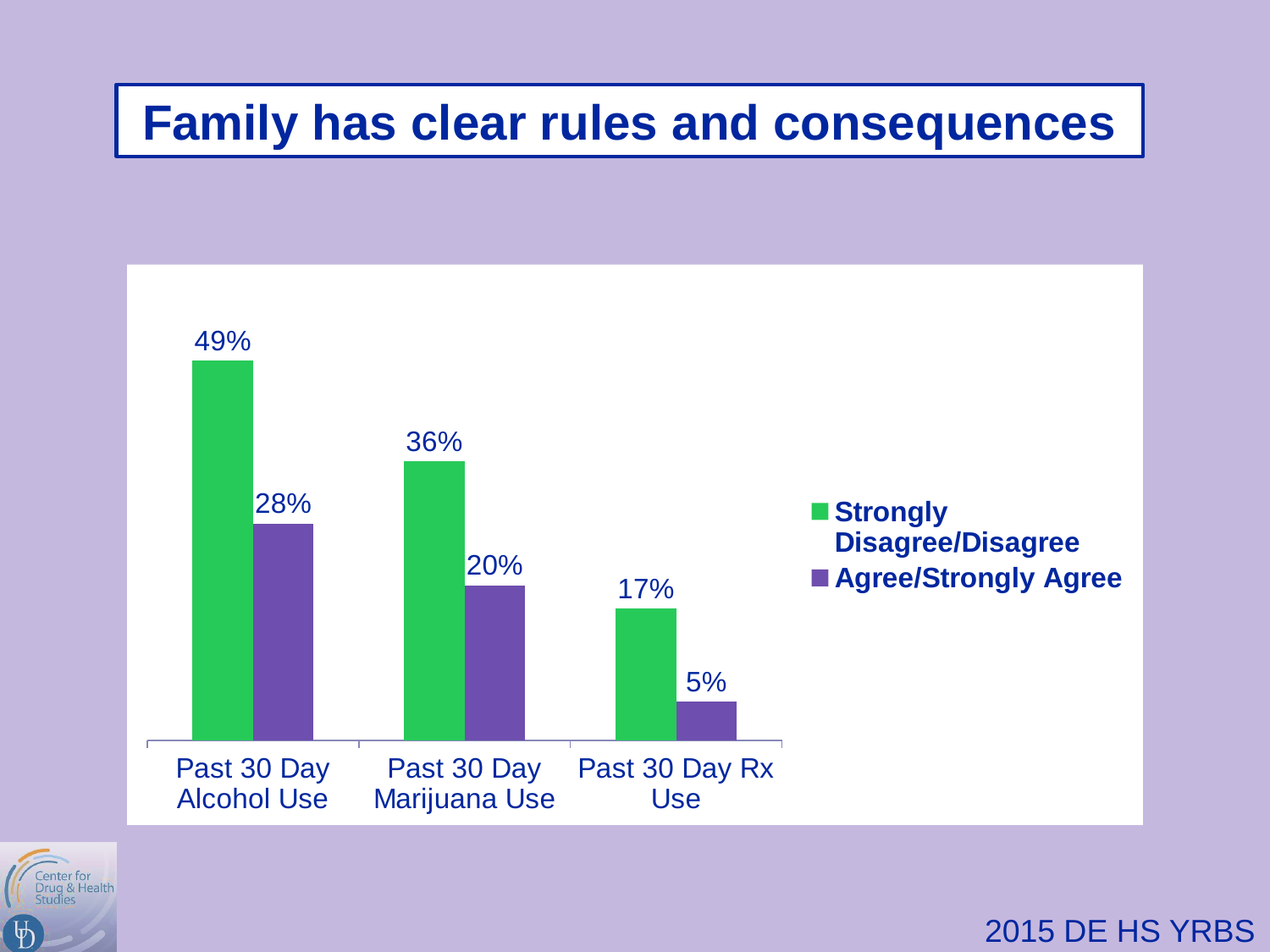
What is the value for Strongly Disagree/Disagree for Past 30 Day Rx Use? 17% What is the difference between the Strongly Disagree/Disagree values for Past 30 Day Marijuana Use and Past 30 Day Rx Use? 19% Which category has the lowest Agree/Strongly Agree value? Past 30 Day Rx Use Which category has the highest Strongly Disagree/Disagree value? Past 30 Day Alcohol Use What is the value for Strongly Disagree/Disagree for Past 30 Day Alcohol Use? 49% What is the difference between the Strongly Disagree/Disagree and Agree/Strongly Agree values for Past 30 Day Alcohol Use? 21% What is the value for Agree/Strongly Agree for Past 30 Day Marijuana Use? 20% How many categories are shown on the x axis? 3 How many series does the legend list? 2 What kind of chart is shown on the slide? Bar chart What is the value for Agree/Strongly Agree for Past 30 Day Rx Use? 5% Which is larger for Past 30 Day Marijuana Use: Strongly Disagree/Disagree or Agree/Strongly Agree? Strongly Disagree/Disagree